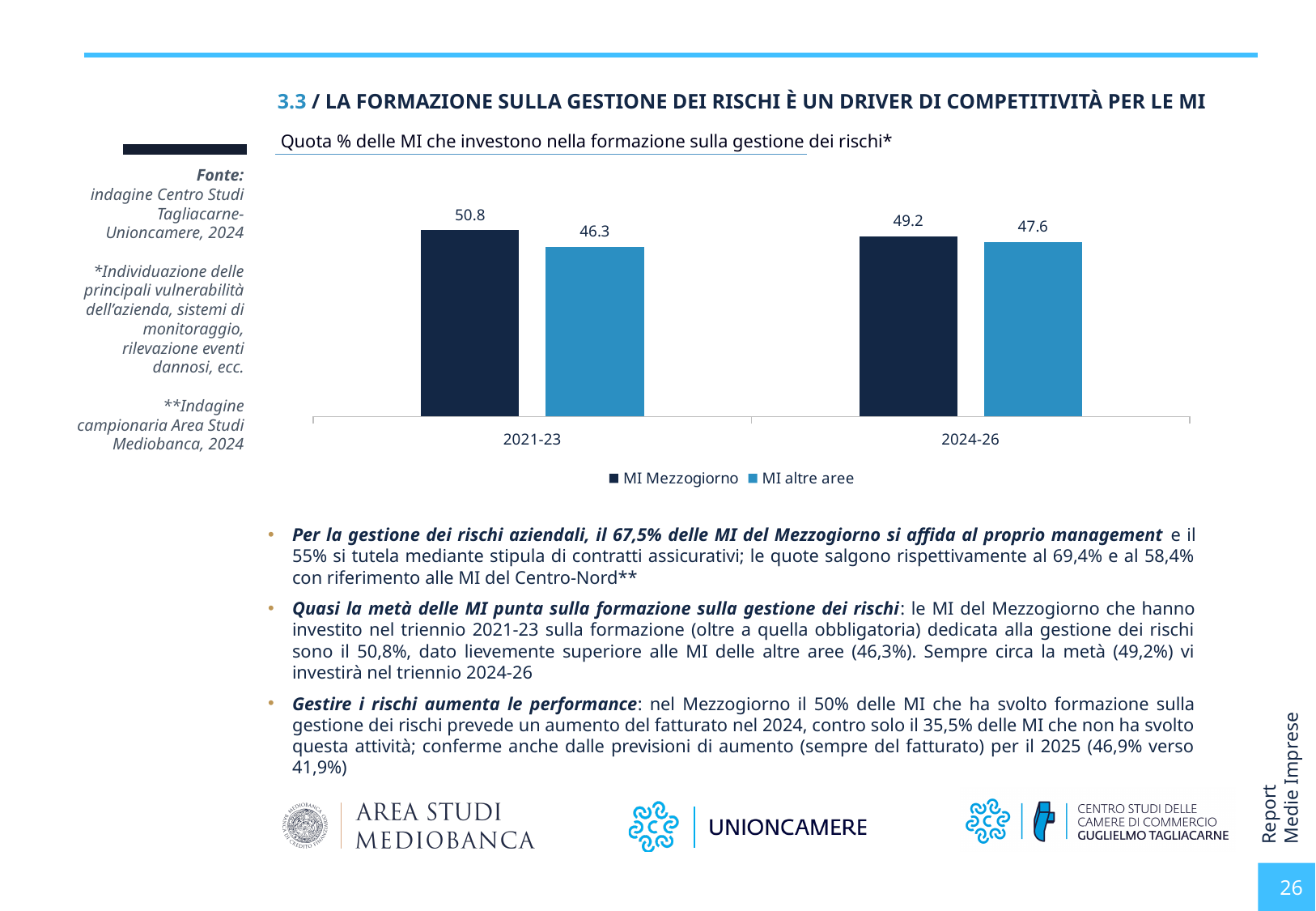
How many periods are shown on the x axis? 2 What kind of chart is shown on the slide? Bar chart What is the difference between MI Mezzogiorno and MI altre aree in 2021-23? 4.5 What is the value for MI Mezzogiorno in 2021-23? 50.8 Which is larger in 2024-26, MI Mezzogiorno or MI altre aree? MI Mezzogiorno Which series has the lowest value in the chart? MI altre aree How many series does the legend list? 2 What is the value for MI altre aree in 2021-23? 46.3 What is the value for MI altre aree in 2024-26? 47.6 Which series has the highest value in the chart? MI Mezzogiorno What is the value for MI Mezzogiorno in 2024-26? 49.2 What is the difference between MI Mezzogiorno and MI altre aree in 2024-26? 1.6